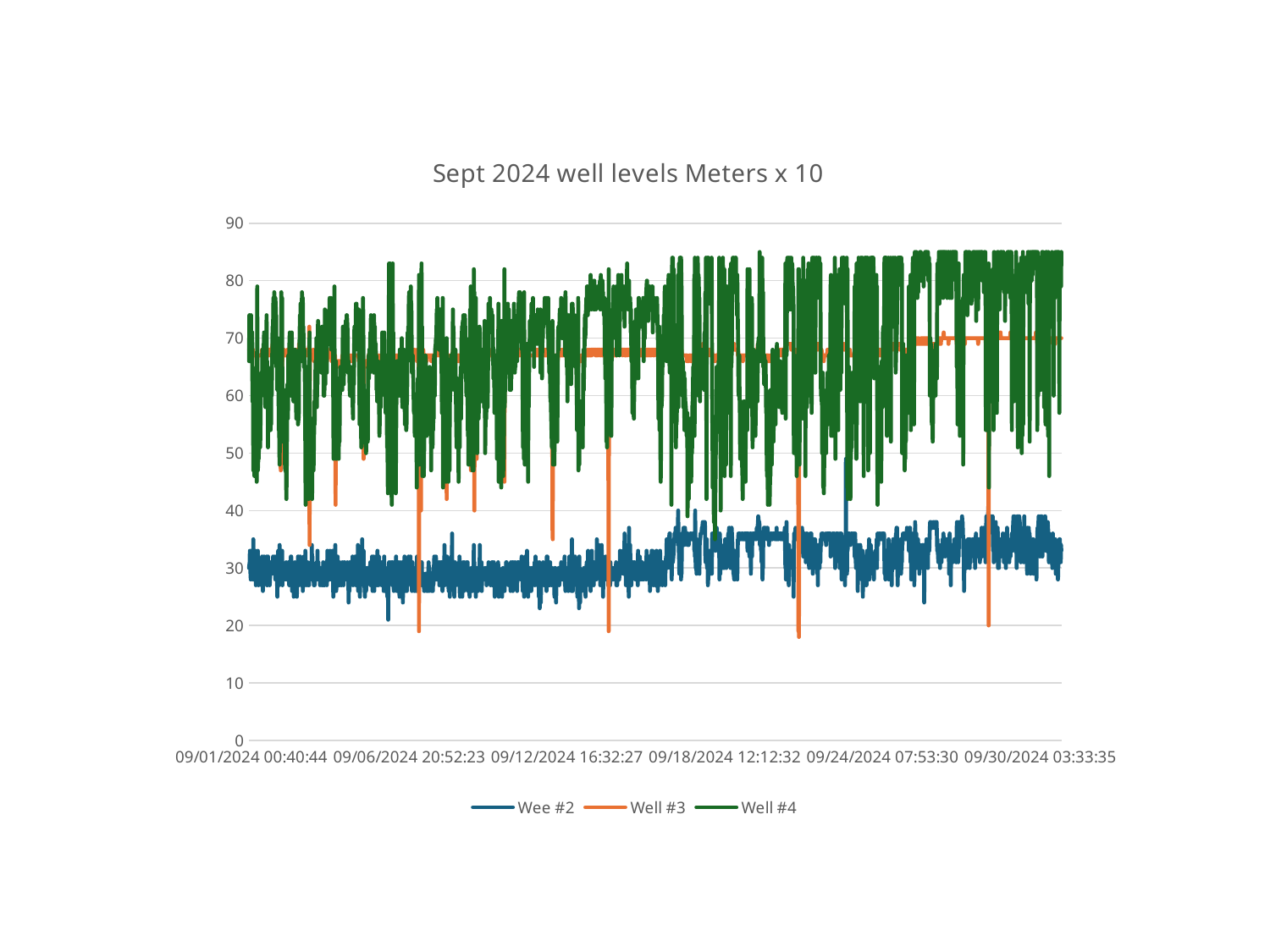
Which series is shown in green in the legend? Well #4 What is the highest value shown on the vertical axis? 90 Do the values for Wee #2 generally rise or fall from the start of September to the end? rise How many series does the legend list? 3 Are the values for Wee #2 generally greater or less than 40? less What kind of chart is shown on the slide? line chart Which series generally has the lowest values on the chart? Wee #2 Is the typical value for Well #3 greater or less than 60? greater Which series has larger values overall, Wee #2 or Well #3? Well #3 Which series generally has the highest values on the chart? Well #4 Are the values for Well #4 generally greater or less than 40? greater What is the title of the chart? Sept 2024 well levels Meters x 10